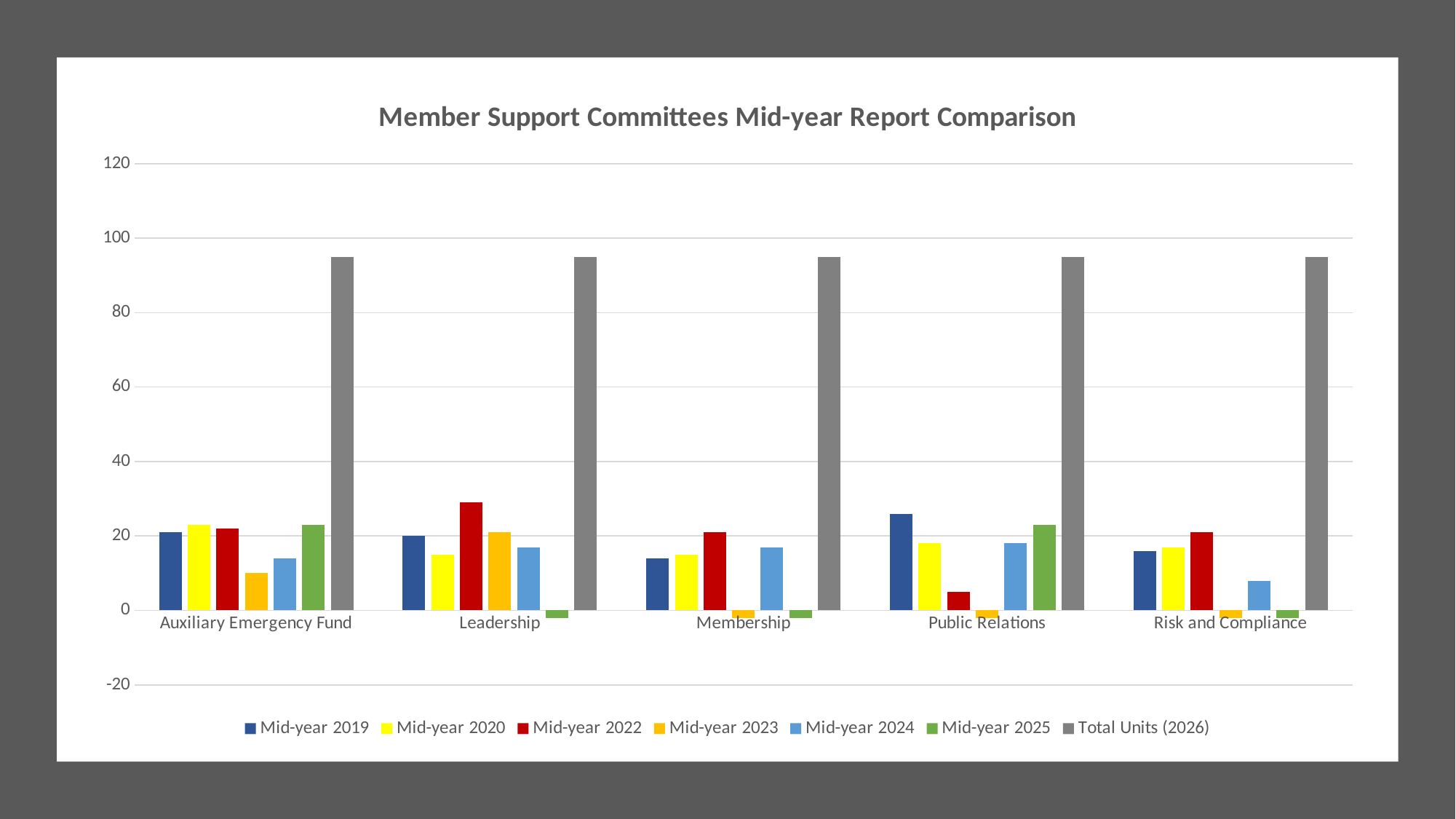
Which is larger: the Mid-year 2022 value for Leadership or the Mid-year 2022 value for Public Relations? Leadership Among the Mid-year series, which has the highest value for Leadership? Mid-year 2022 How many series does the legend list? 7 Is the Mid-year 2022 value for Leadership greater or less than 20? greater What is the title of the chart? Member Support Committees Mid-year Report Comparison Is the Total Units (2026) value for Membership greater or less than 80? greater How many committee categories are shown on the x axis? 5 What kind of chart is shown on the slide? Bar chart Is the Mid-year 2023 value for Auxiliary Emergency Fund greater or less than 20? less Which series has the lowest value for Public Relations? Mid-year 2023